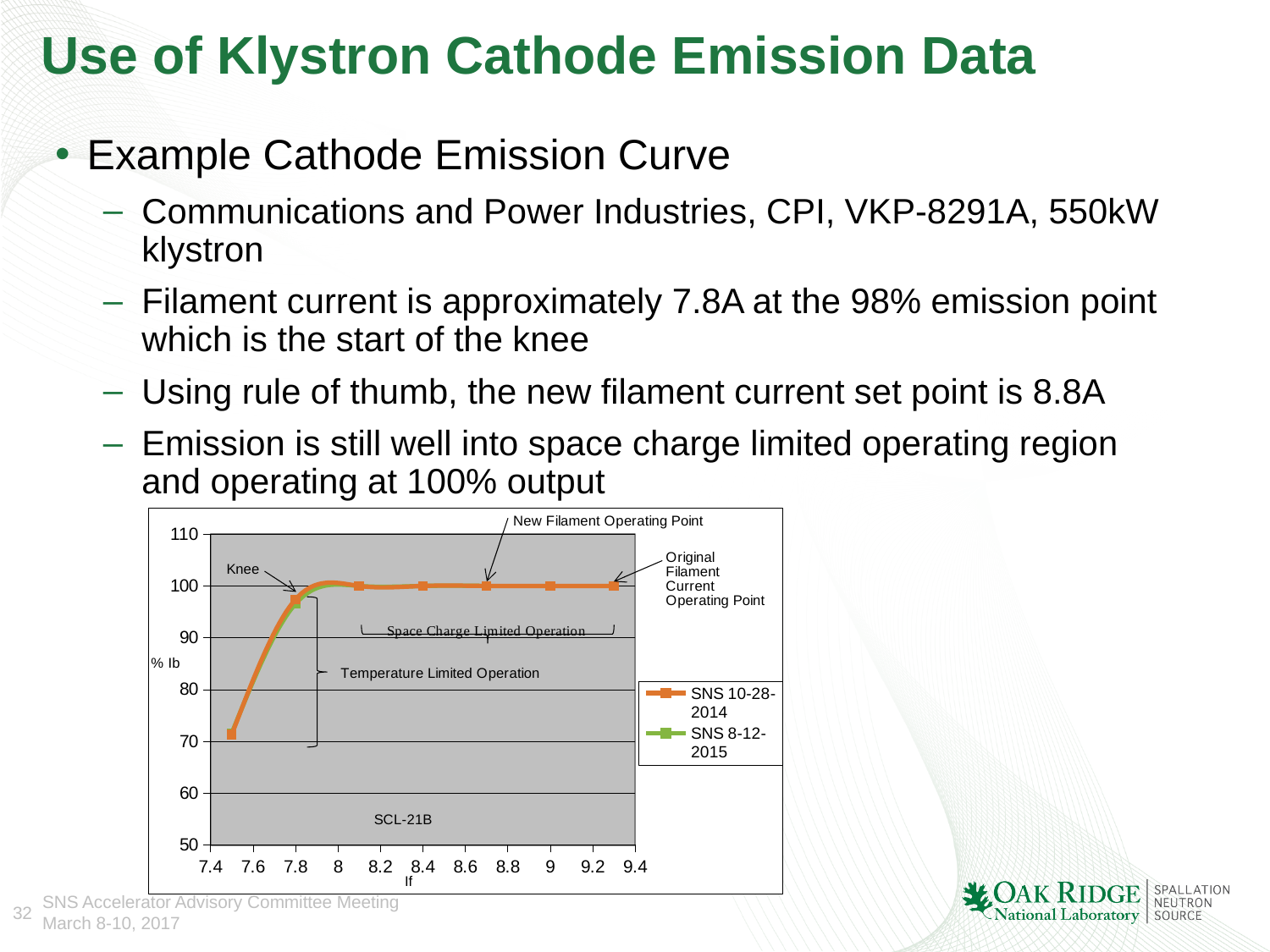
What is the label of the chart's y axis? % Ib Is the value of the SNS 10-28-2014 series at If = 8.4 greater or less than 90? greater How many marked data points does the SNS 10-28-2014 series have? 7 Is the value of the SNS 10-28-2014 series at If = 9.3 greater or less than 90? greater Is the value of the SNS 10-28-2014 series at If = 7.5 greater or less than 80? less What is the highest value shown on the chart's y axis? 110 What kind of chart is shown on the slide? line chart Which is larger for the SNS 10-28-2014 series: the value at If = 7.5 or the value at If = 8.1? the value at If = 8.1 How many series does the chart legend list? 2 Which point of the SNS 10-28-2014 series has the lowest % Ib value, the one at If = 7.5 or the one at If = 9.3? If = 7.5 What are the two series named in the chart legend? SNS 10-28-2014 and SNS 8-12-2015 Do the values of the SNS 10-28-2014 series rise or fall as If increases from 7.4 to 7.8? rise